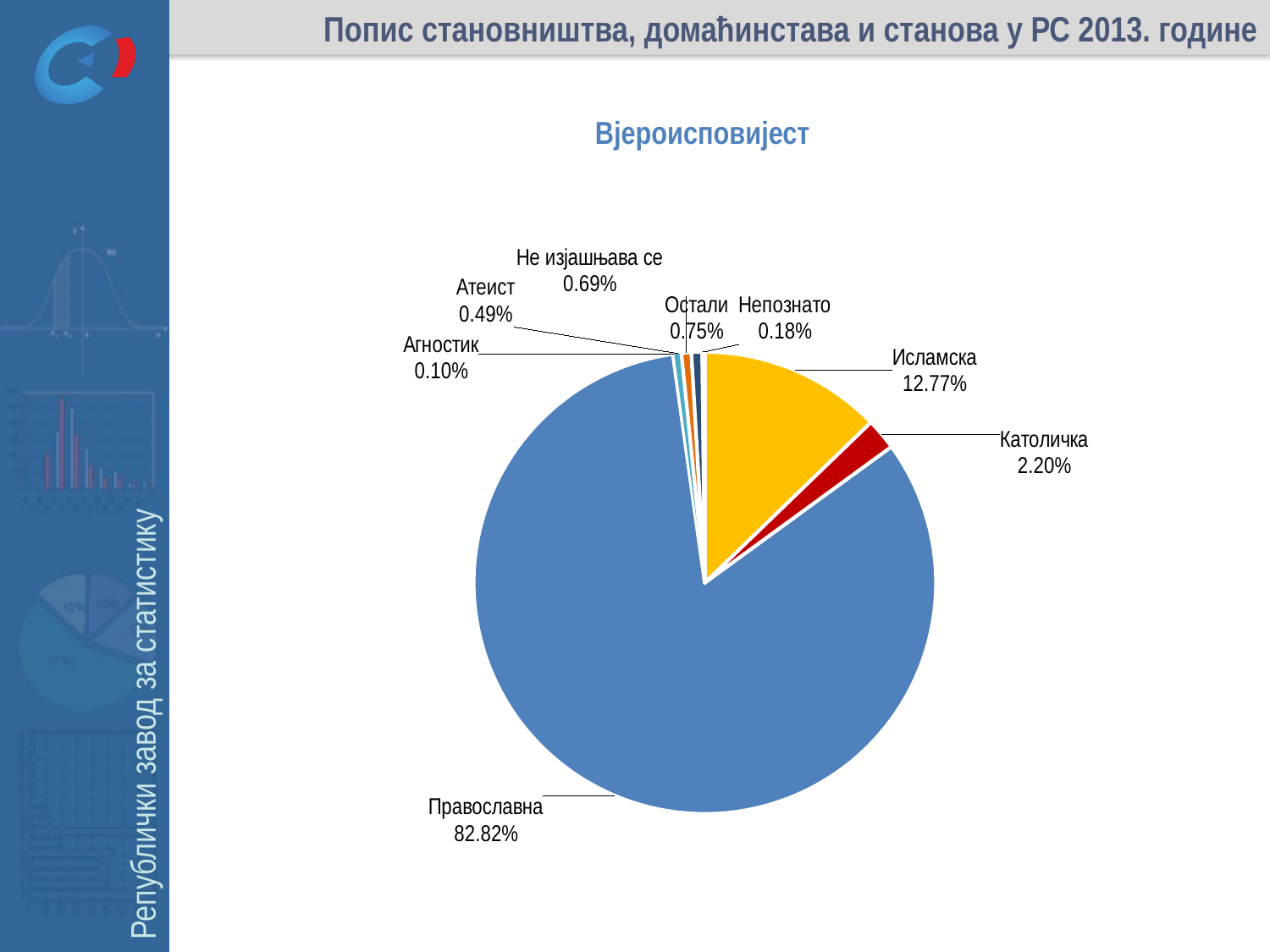
What type of chart is shown on the slide? pie chart Which category has the largest slice of the pie? Православна What is the value shown for Католичка? 2.20% What is the value shown for Агностик? 0.10% What share of the pie does Православна have? 82.82% What is the title of the chart? Вјероисповијест How many categories are shown in the pie chart? 8 What is the value shown for Исламска? 12.77% Which is larger, the value for Остали or the value for Атеист? Остали What is the value shown for Непознато? 0.18% Which category has the smallest slice of the pie? Агностик What is the difference between the values for Православна and Исламска? 70.05%